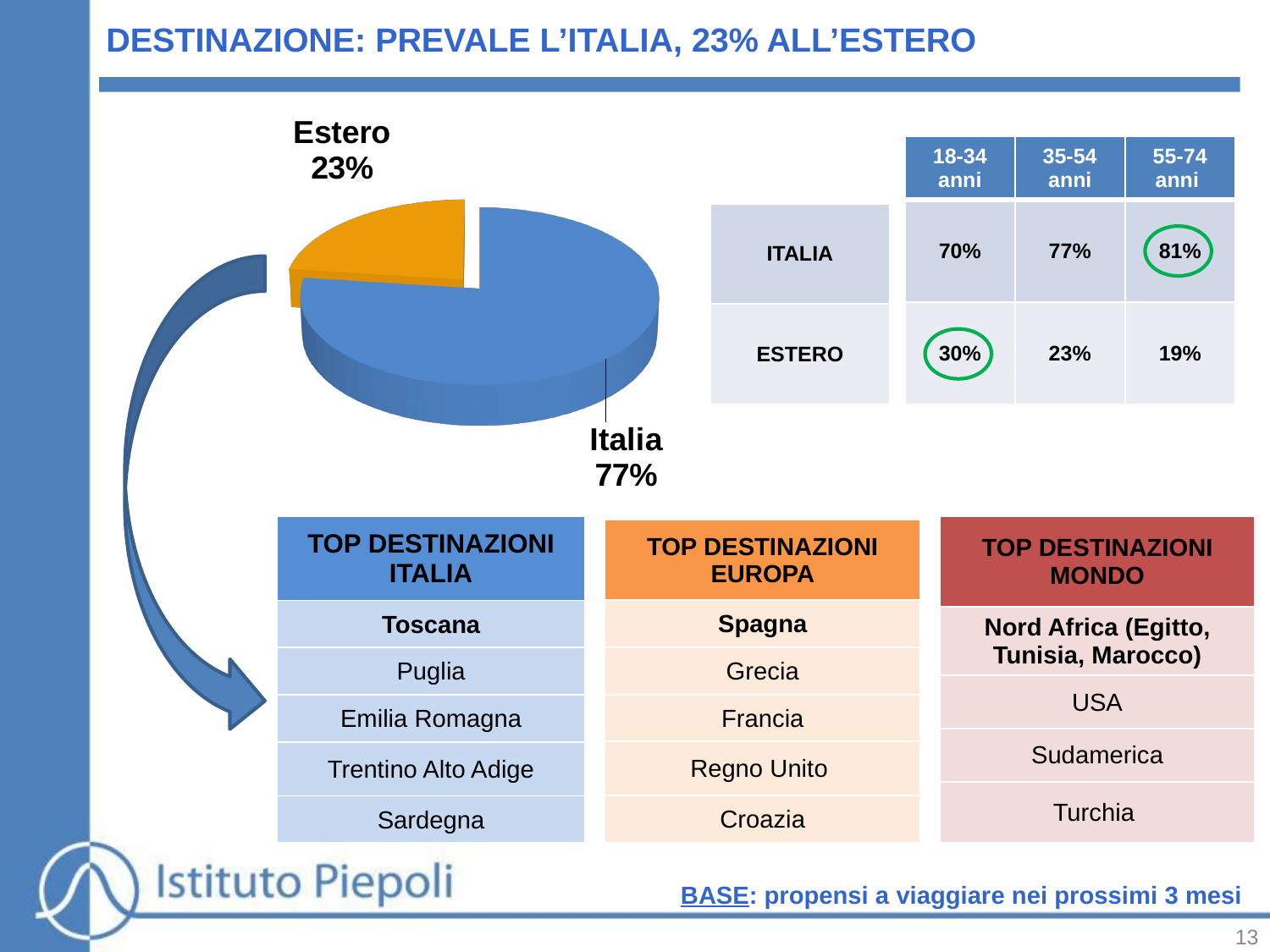
What share of the pie chart is labelled Estero? 23% What is the total of the two slices shown in the pie chart? 100% Which slice of the pie chart is the largest? Italia Which slice of the pie chart is the smallest? Estero What share of the pie chart is labelled Italia? 77% How many slices does the pie chart have? 2 What colour is the Estero slice of the pie chart? orange What is the difference in percentage points between the Italia slice and the Estero slice of the pie chart? 54 What kind of chart is shown on the slide? pie chart What colour is the Italia slice of the pie chart? blue Which is larger in the pie chart, Italia or Estero? Italia